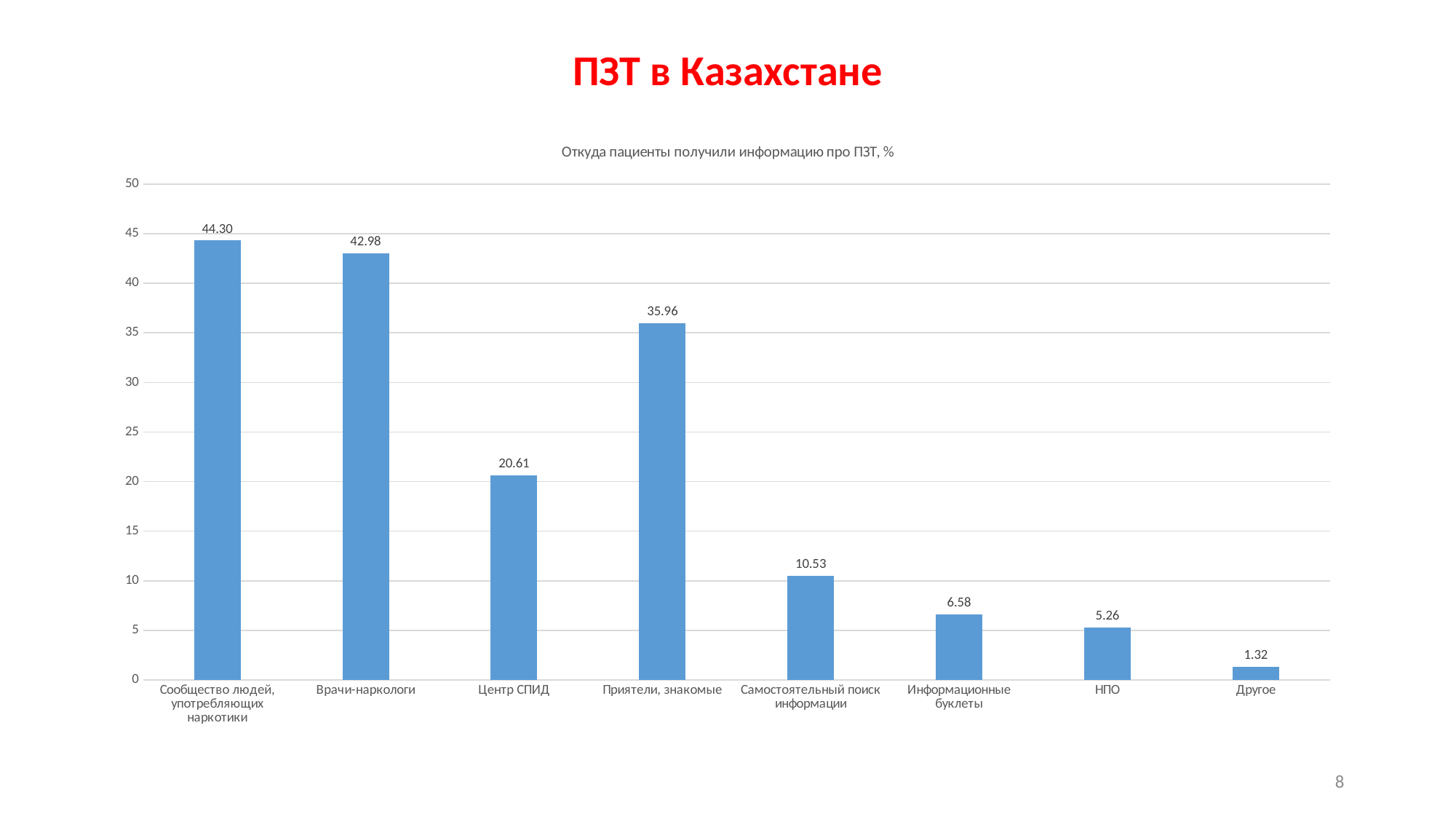
What kind of chart is shown on the slide? bar chart What is the value for Самостоятельный поиск информации? 10.53 What is the value for Другое? 1.32 Which category has the lowest value? Другое Which is larger, the value for Информационные буклеты or the value for НПО? Информационные буклеты Is the value for Приятели, знакомые greater or less than 30? greater How many categories are shown on the chart? 8 What is the difference between the values for Приятели, знакомые and Центр СПИД? 15.35 What is the value for Врачи-наркологи? 42.98 What is the value for Центр СПИД? 20.61 Which category has the highest value? Сообщество людей, употребляющих наркотики What is the title of the chart? Откуда пациенты получили информацию про ПЗТ, %